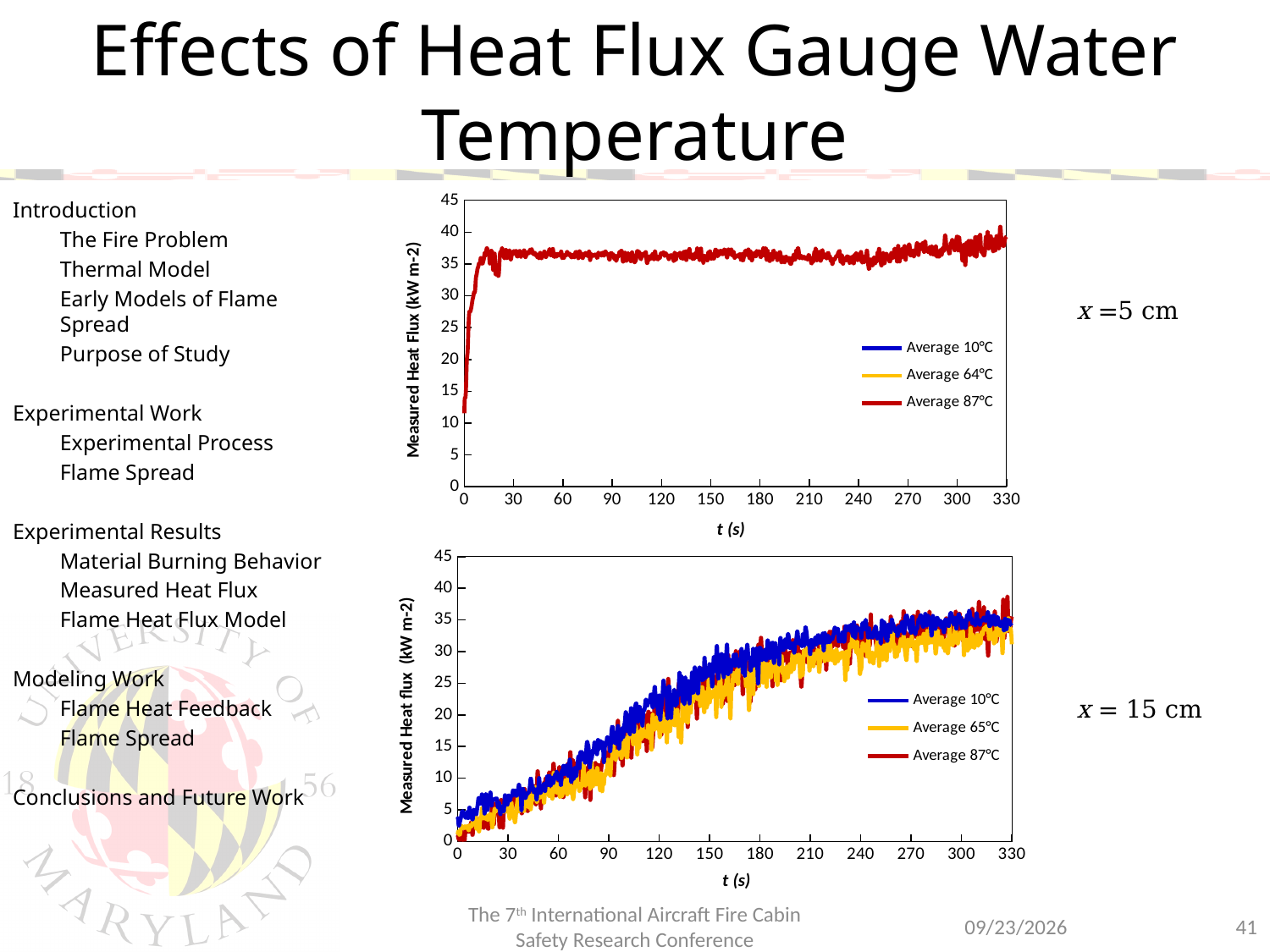
In the top chart (x = 5 cm), is the measured heat flux of the Average 87°C series at t = 150 s greater or less than 30? greater In the top chart (x = 5 cm), is the measured heat flux of the Average 87°C series at t = 150 s greater or less than 40? less In the bottom chart (x = 15 cm), is the measured heat flux of the Average 10°C series at t = 30 s greater or less than 10? less How many series does the legend of the top chart (x = 5 cm) list? 3 In the bottom chart (x = 15 cm), do the measured heat flux values rise or fall as t increases? rise What is the y-axis label of the top chart (x = 5 cm)? Measured Heat Flux (kW m-2) What kind of chart is the top chart (x = 5 cm)? line chart In the bottom chart (x = 15 cm), what is the maximum value shown on the x axis? 330 What is the x-axis label of the bottom chart (x = 15 cm)? t (s) What kind of chart is the bottom chart (x = 15 cm)? line chart How many series does the legend of the bottom chart (x = 15 cm) list? 3